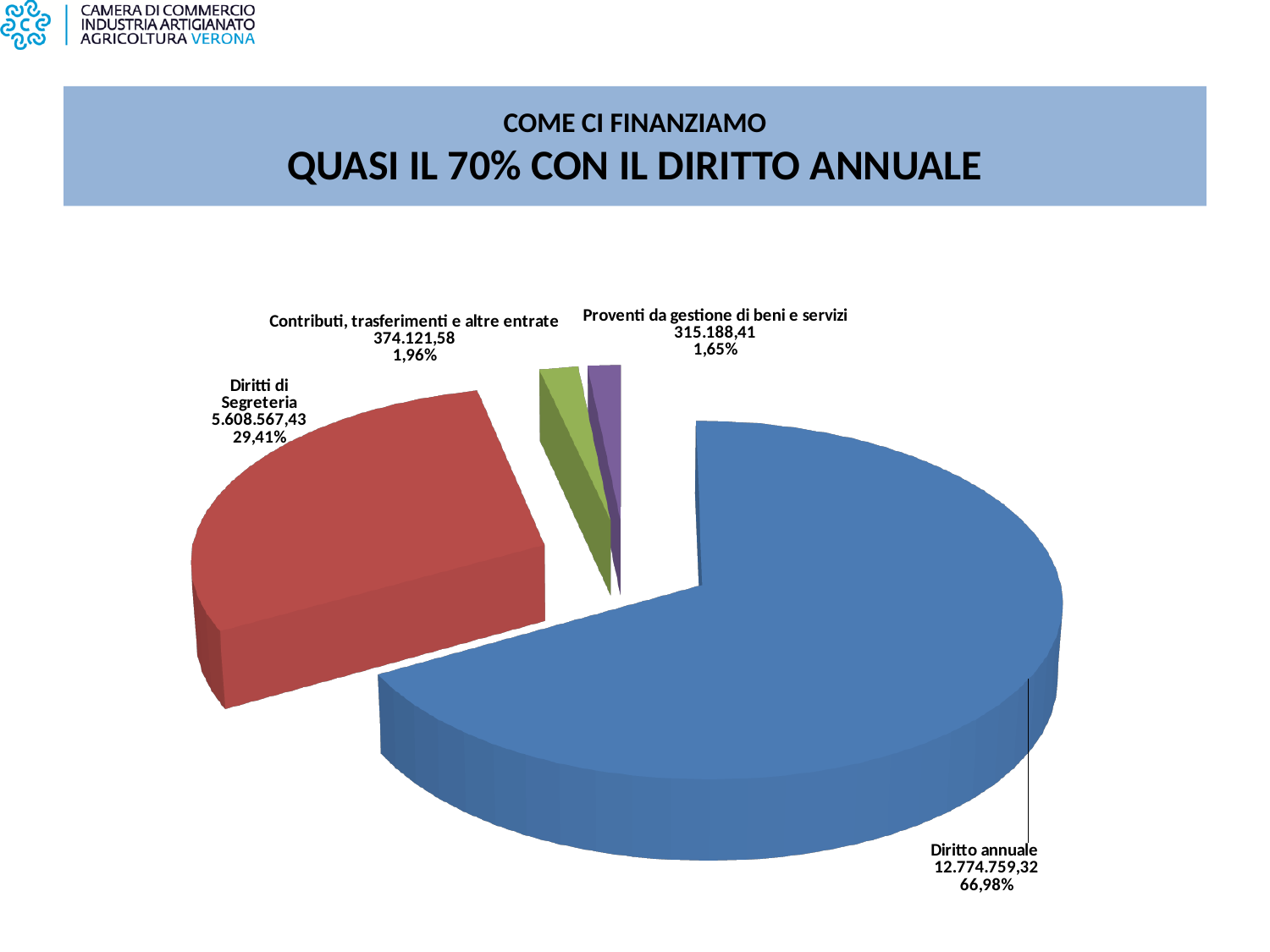
How many slices does the pie chart have? 4 What is the value shown for Diritti di Segreteria? 5.608.567,43 Which is larger, Diritti di Segreteria or Contributi, trasferimenti e altre entrate? Diritti di Segreteria What colour is the Diritto annuale slice? blue Which category has the smallest slice of the pie? Proventi da gestione di beni e servizi What is the value shown for Contributi, trasferimenti e altre entrate? 374.121,58 Which category has the largest slice of the pie? Diritto annuale What is the value shown for Diritto annuale? 12.774.759,32 What percentage share does Diritti di Segreteria have? 29,41% What kind of chart is shown on the slide? pie chart What percentage share does Proventi da gestione di beni e servizi have? 1,65% What is the difference in percentage share between Diritto annuale and Diritti di Segreteria? 37,57%